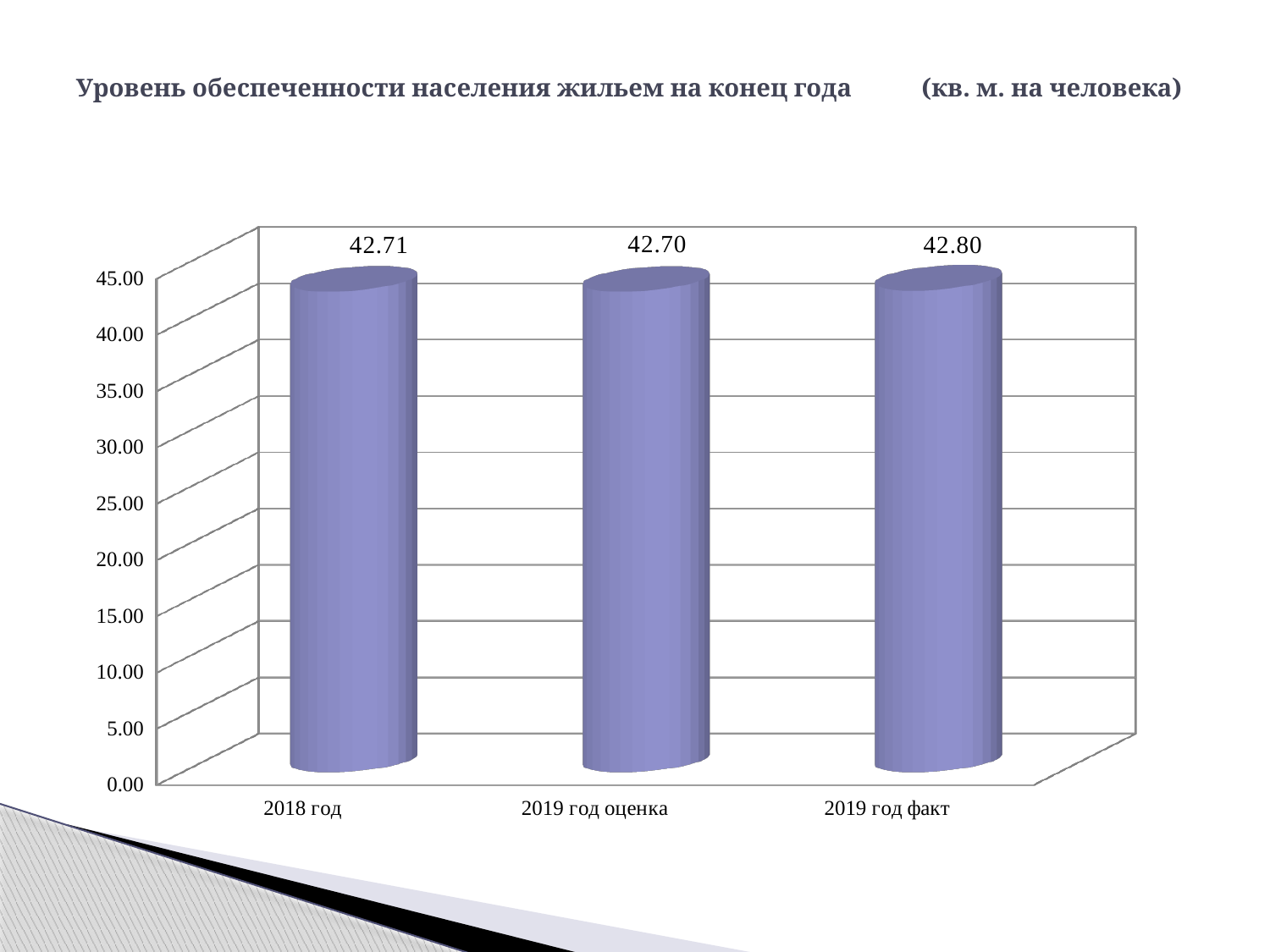
What is the difference between the values for 2019 год факт and 2019 год оценка? 0.10 According to the data labels, which is larger: the value for 2019 год факт or the value for 2018 год? 2019 год факт Which category has the highest value according to the data labels? 2019 год факт What is the value for 2019 год оценка? 42.70 What is the value for 2018 год? 42.71 What kind of chart is shown on the slide? bar chart Is the value for 2018 год greater or less than 40.00? greater Which category has the lowest value according to the data labels? 2019 год оценка How many categories are shown on the x axis? 3 What is the value for 2019 год факт? 42.80 What is the title of the chart? Уровень обеспеченности населения жильем на конец года (кв. м. на человека) What is the difference between the values for 2019 год факт and 2018 год? 0.09